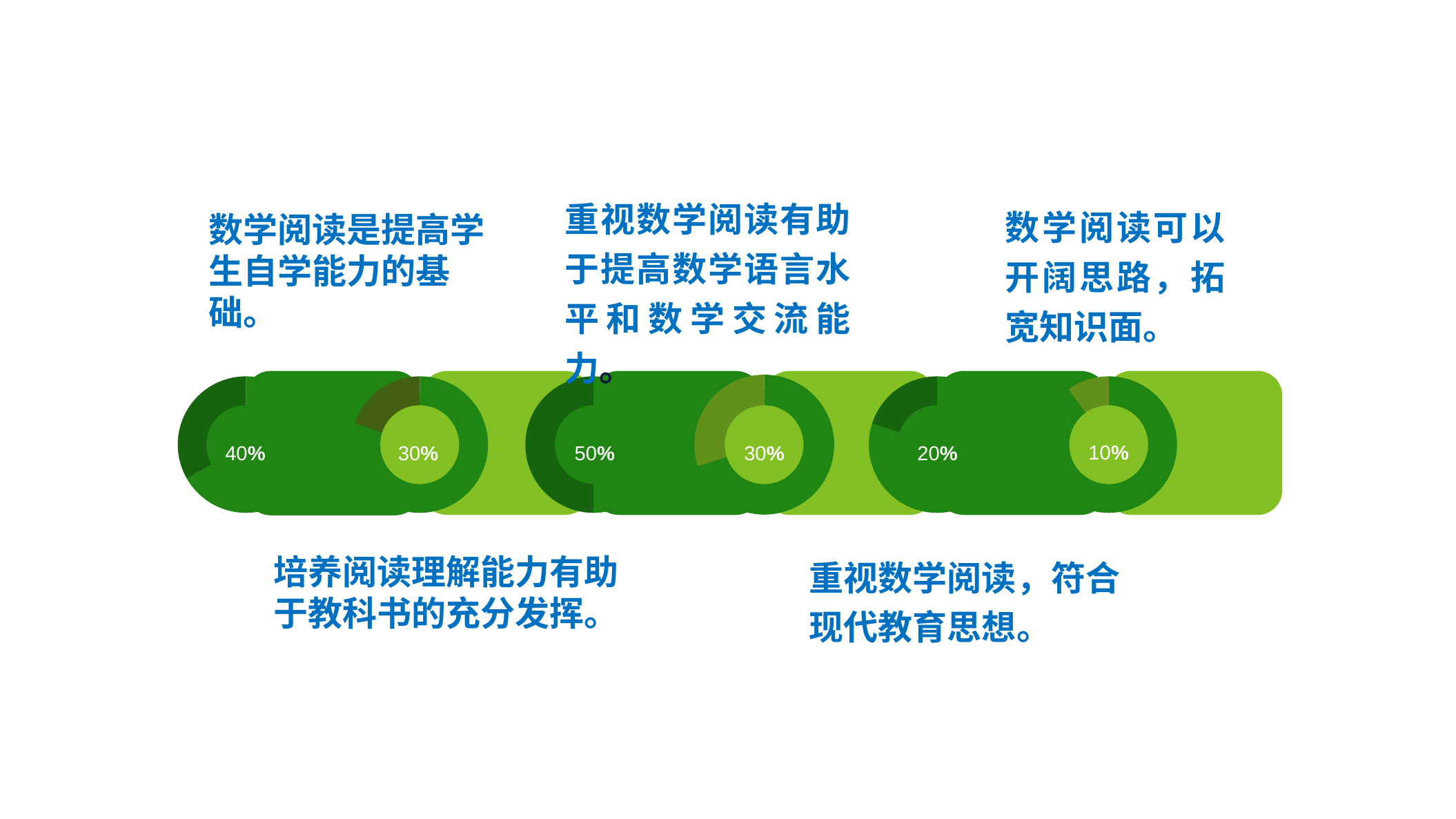
What value is shown in the third ring chart from the left? 50% What kind of chart is used to display the percentages on the slide? Donut (ring) chart How many ring charts are shown on the slide? 6 What value is shown in the rightmost ring chart on the slide? 10% What value is shown in the leftmost ring chart on the slide? 40% What value is shown in the second ring chart from the left? 30% What value is shown in the fifth ring chart from the left? 20% Which is larger: the value in the leftmost ring chart or the value in the fifth ring chart from the left? The leftmost (40%) Which ring chart shows the highest percentage? The third from the left (50%) What is the difference between the values in the leftmost ring chart (40%) and the second ring chart from the left (30%)? 10% Which ring chart shows the lowest percentage? The rightmost (10%) What is the difference between the value in the third ring chart (50%) and the value in the rightmost ring chart (10%)? 40%